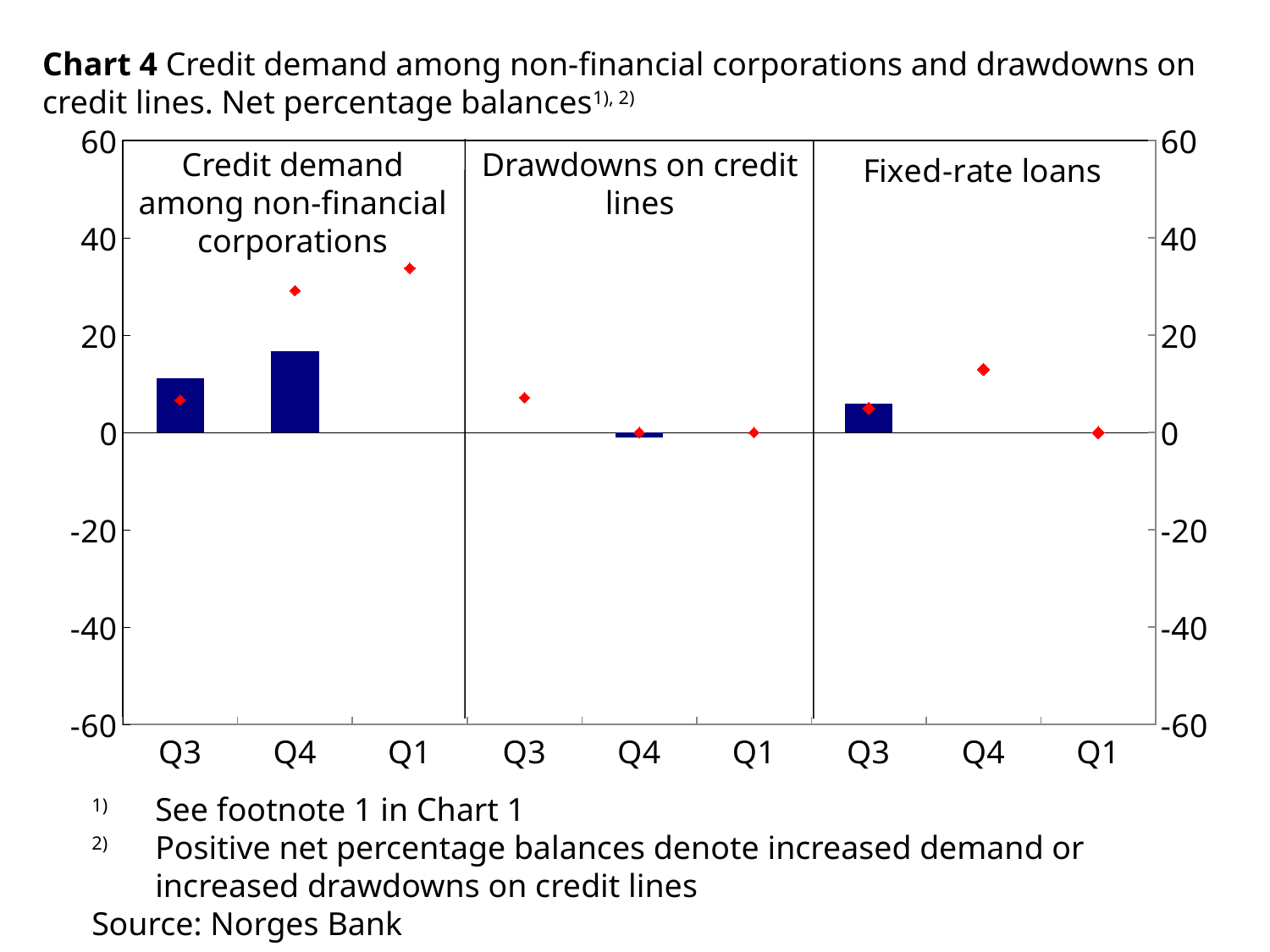
In the 'Credit demand among non-financial corporations' panel, do the red markers rise or fall from Q3 to Q1? rise How many panels does the chart have? 3 In the 'Credit demand among non-financial corporations' panel, which quarter has the highest red marker? Q1 In the 'Fixed-rate loans' panel, which quarter has the highest red marker? Q4 What source is given for the chart? Norges Bank In the 'Drawdowns on credit lines' panel, is the red marker for Q3 greater or less than 0? greater How many quarters are shown on the x axis of each panel? 3 In the 'Credit demand among non-financial corporations' panel, which bar is taller, Q3 or Q4? Q4 In the 'Fixed-rate loans' panel, which red marker is higher, Q4 or Q1? Q4 What kind of chart is shown on the slide? combination bar and line chart (bars with red diamond markers) In the 'Credit demand among non-financial corporations' panel, is the bar for Q4 greater or less than 20? less In the 'Credit demand among non-financial corporations' panel, is the red marker for Q1 greater or less than 20? greater